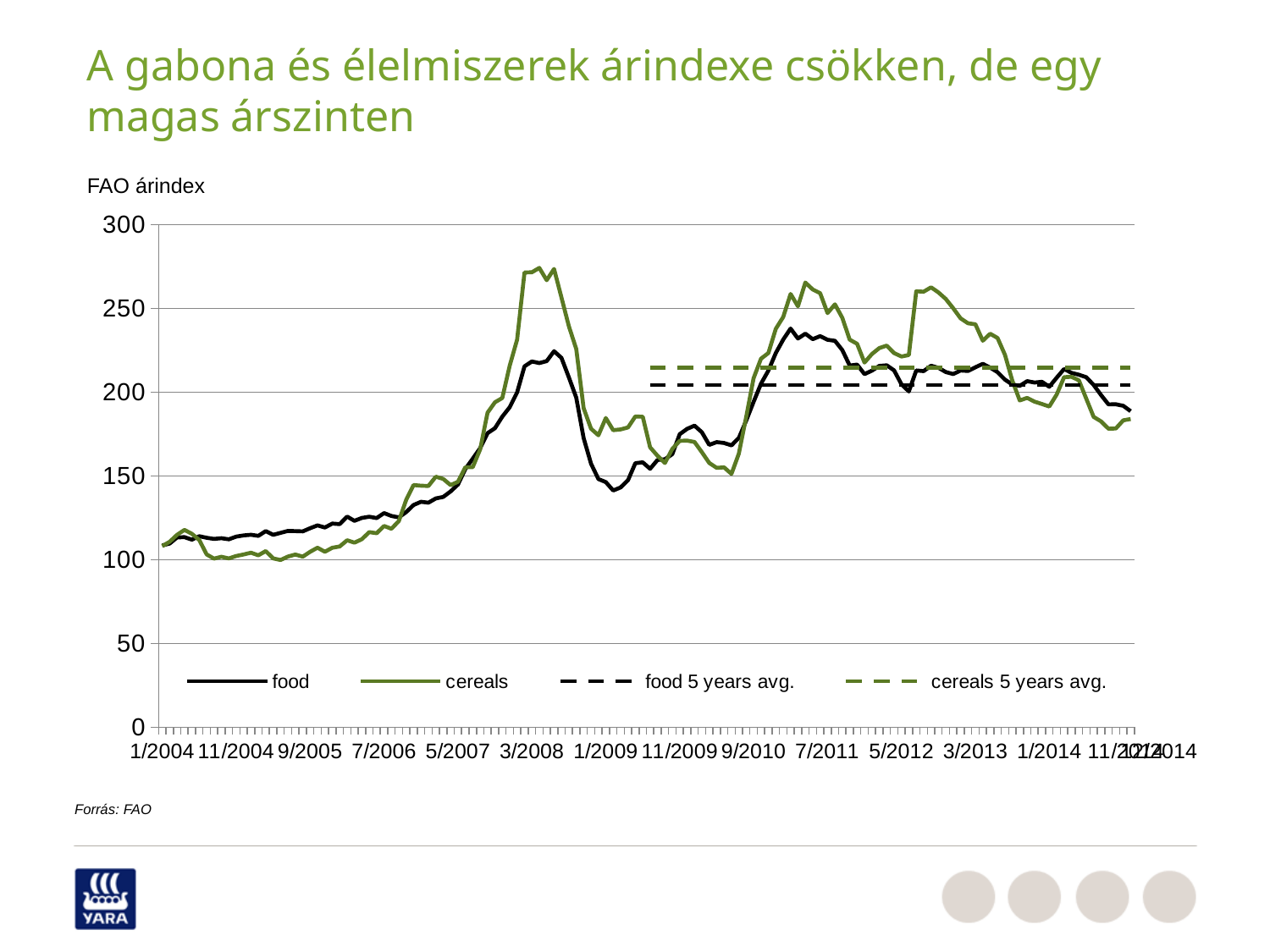
Is the peak value of the food series around 3/2008 greater or less than 250? less Is the peak value of the cereals series around 3/2008 greater or less than 250? greater How many series does the legend list? 4 What are the four series listed in the legend? food, cereals, food 5 years avg., cereals 5 years avg. Which series reaches the highest value anywhere on the chart, food or cereals? cereals Is the value of the cereals series at 1/2009 greater or less than 200? less What kind of chart is shown on the slide? line chart Does the food series rise or fall between 1/2004 and 3/2008? rise Which 5 years average line is higher, food 5 years avg. or cereals 5 years avg.? cereals 5 years avg. Around 3/2008, which series is higher, food or cereals? cereals What is the label shown above the chart's vertical axis? FAO árindex